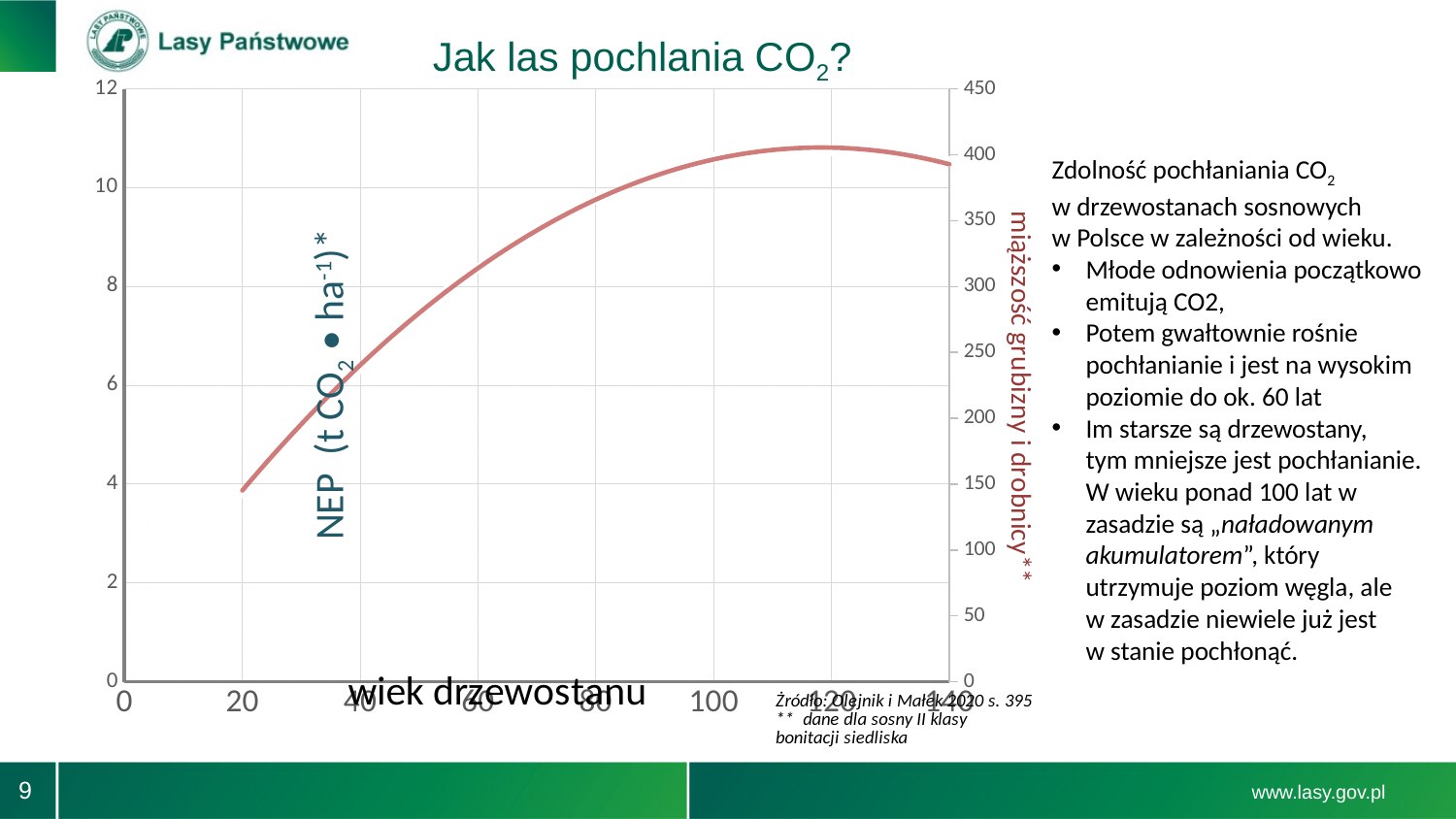
What is the highest tick value shown on the right-hand y axis? 450 Between stand age 120 and stand age 140, does the curve rise or fall? fall Reading against the left axis, is the value of the curve at stand age 100 greater or less than 10? greater How many curves are plotted on the chart? 1 Between stand age 20 and stand age 80, does the curve rise or fall? rise What kind of chart is shown on the slide? line chart Reading against the left axis, is the value of the curve at stand age 60 greater or less than 6? greater Is the curve's value at stand age 100 larger or smaller than its value at stand age 20? larger Reading against the left axis, is the value of the curve at stand age 140 greater or less than 8? greater What is the title of the chart on the slide? Jak las pochlania CO2? What is the label of the x axis of the chart? wiek drzewostanu